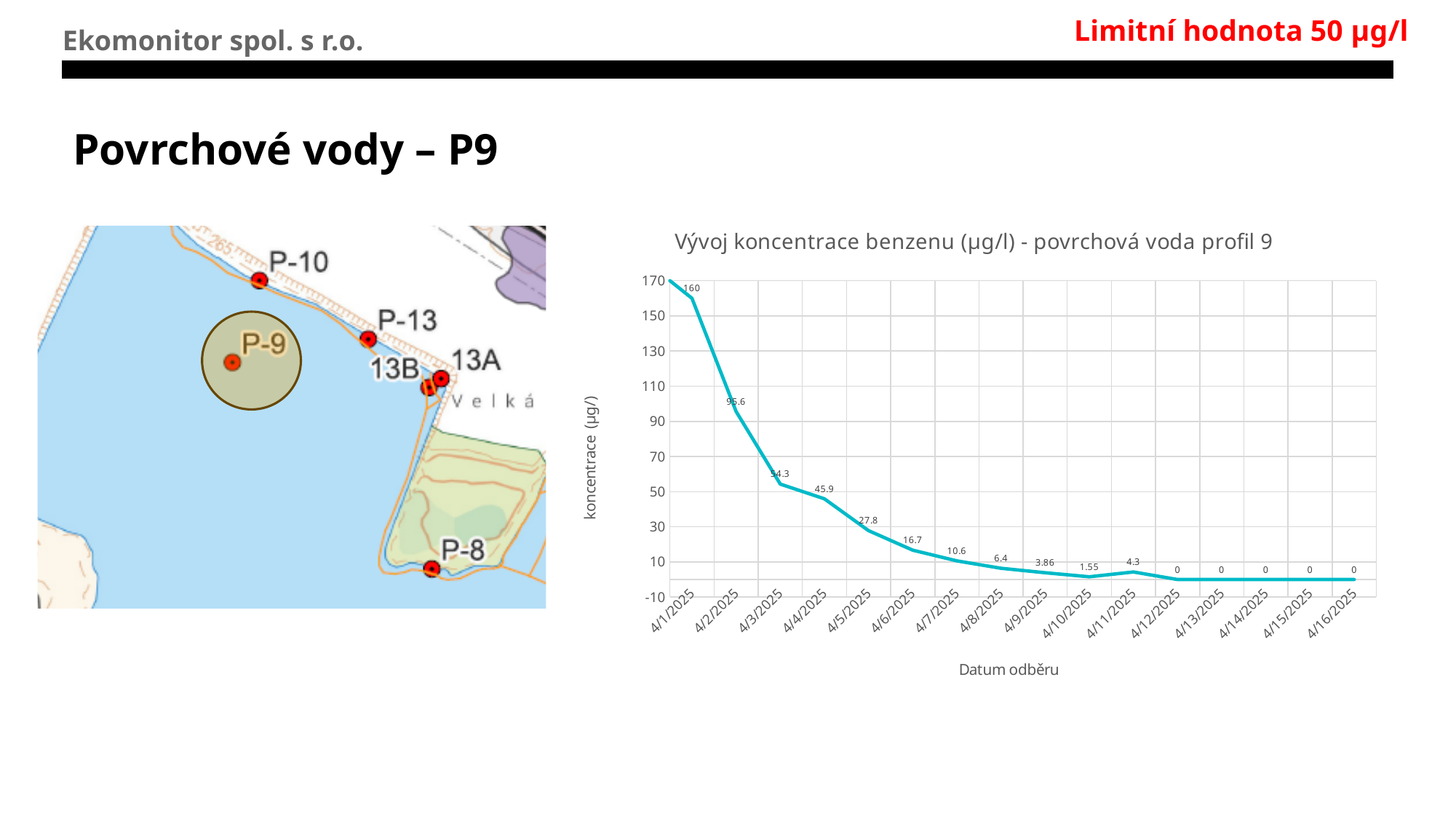
What is the label of the y axis? koncentrace (µg/l) What is the benzene concentration on 4/11/2025? 4.3 Which date has the larger concentration, 4/10/2025 or 4/11/2025? 4/11/2025 What is the benzene concentration on 4/3/2025? 54.3 What is the difference between the concentrations on 4/1/2025 and 4/2/2025? 64.4 On which date is the benzene concentration highest? 4/1/2025 What is the difference between the concentrations on 4/4/2025 and 4/5/2025? 18.1 Do the concentration values generally rise or fall from 4/1/2025 to 4/16/2025? fall What type of chart is shown on the slide? line chart What is the benzene concentration on 4/9/2025? 3.86 How many sampling dates are plotted on the x axis? 16 What is the benzene concentration on 4/1/2025? 160